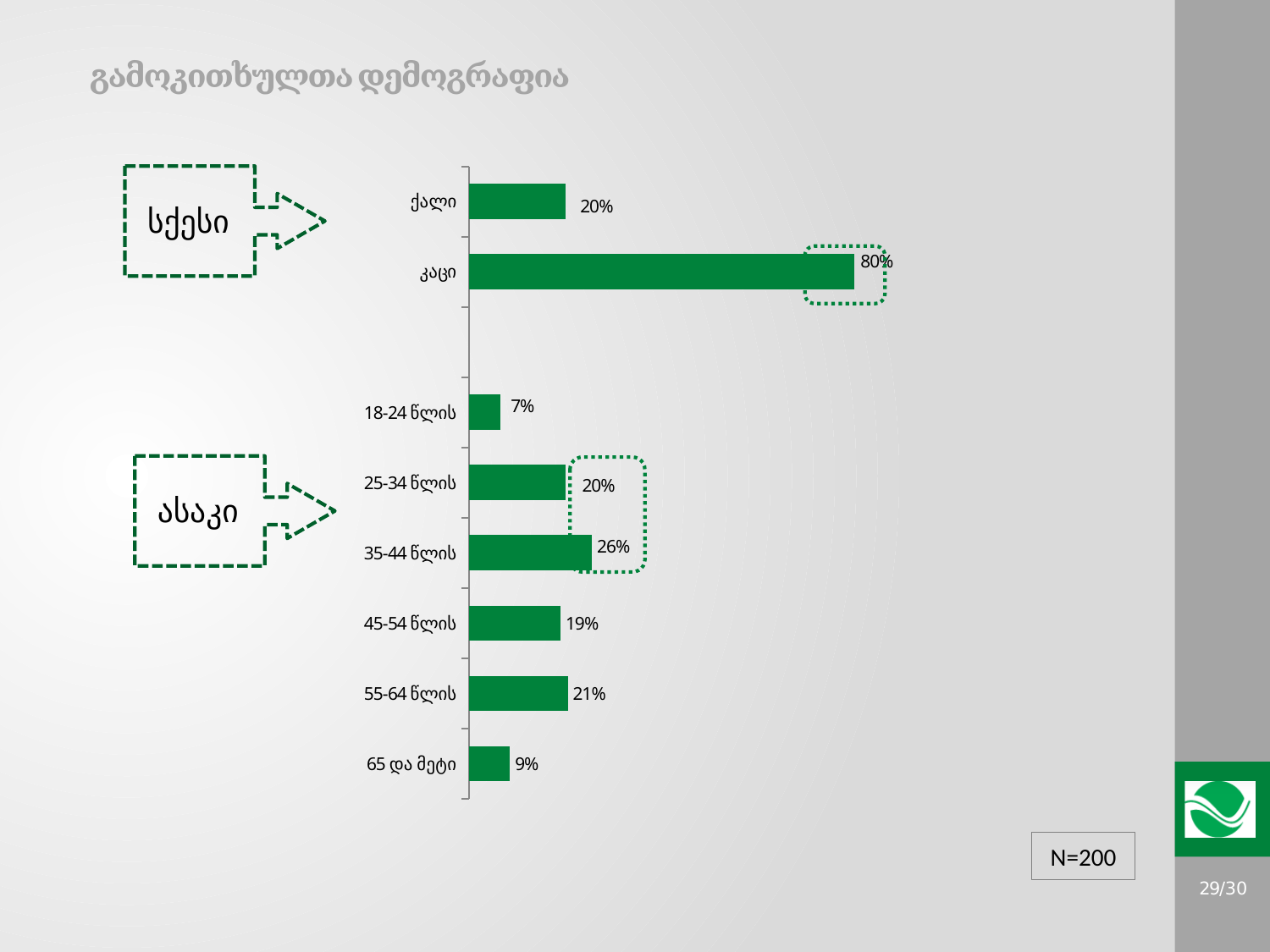
How many age groups are shown in the chart? 6 Which is larger, the value for 55-64 წლის or 45-54 წლის? 55-64 წლის Which age group has the lowest value? 18-24 წლის What is the value for ქალი? 20% What is the difference between the values for კაცი and ქალი? 60% What is the value for 35-44 წლის? 26% What is the difference between the values for 35-44 წლის and 45-54 წლის? 7% What kind of chart is shown on the slide? Bar chart What is the title of the slide? გამოკითხულთა დემოგრაფია What is the value for 65 და მეტი? 9% Which age group has the highest value? 35-44 წლის What is the value for კაცი? 80%